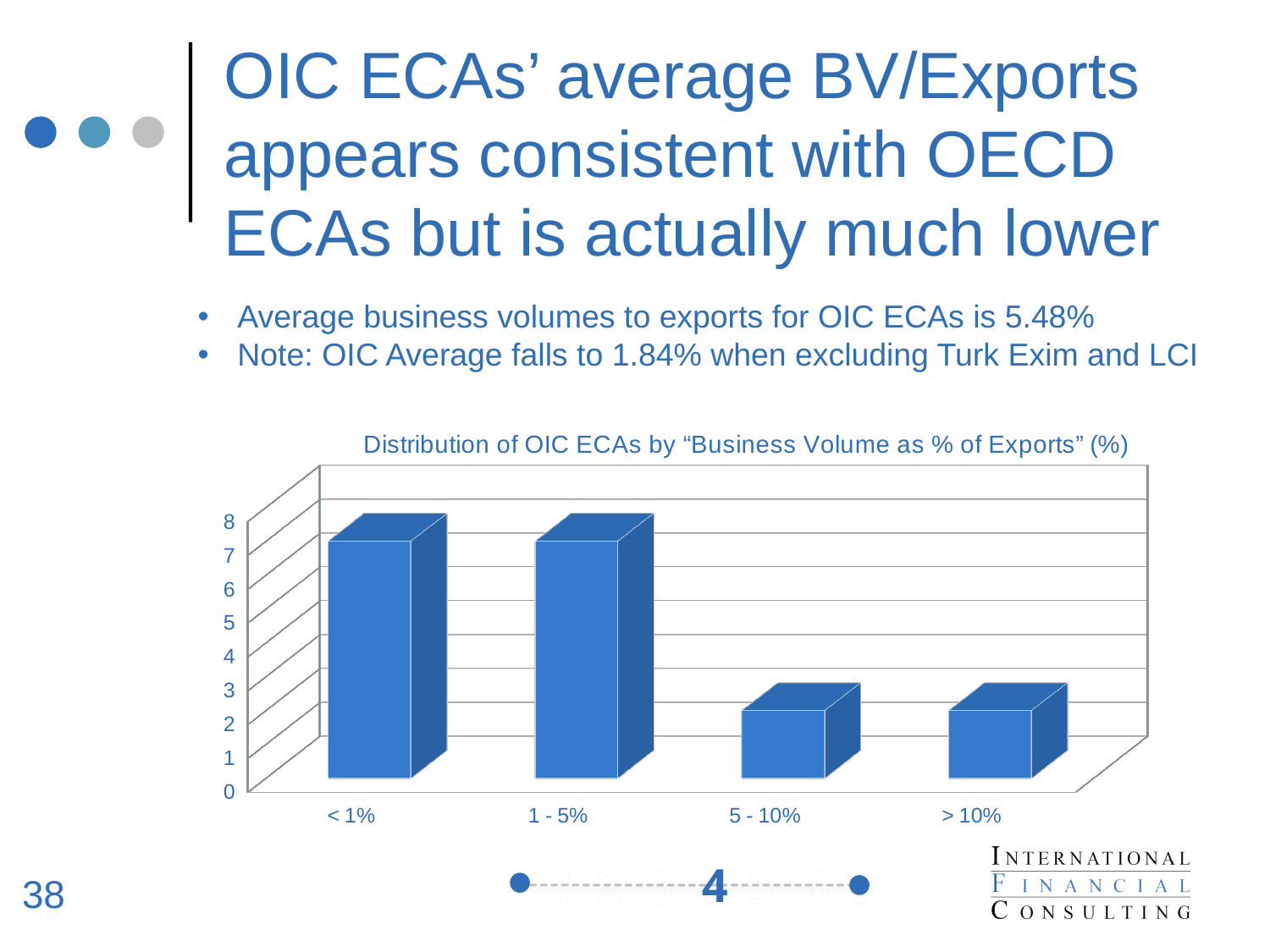
Is the value for the "> 10%" category greater or less than 5? less What is the title of the chart? Distribution of OIC ECAs by "Business Volume as % of Exports" (%) What kind of chart is shown on the slide? bar chart Is the value for the "< 1%" category greater or less than 5? greater How many categories are shown on the x axis of the chart? 4 What is the highest value shown on the y axis? 8 Do the values generally rise or fall moving from left to right along the x axis? fall Is the value for the "5 - 10%" category greater or less than 4? less Which is larger, the value for "< 1%" or the value for "5 - 10%"? < 1% Which is larger, the value for "1 - 5%" or the value for "> 10%"? 1 - 5% What is the label of the first category on the x axis? < 1%